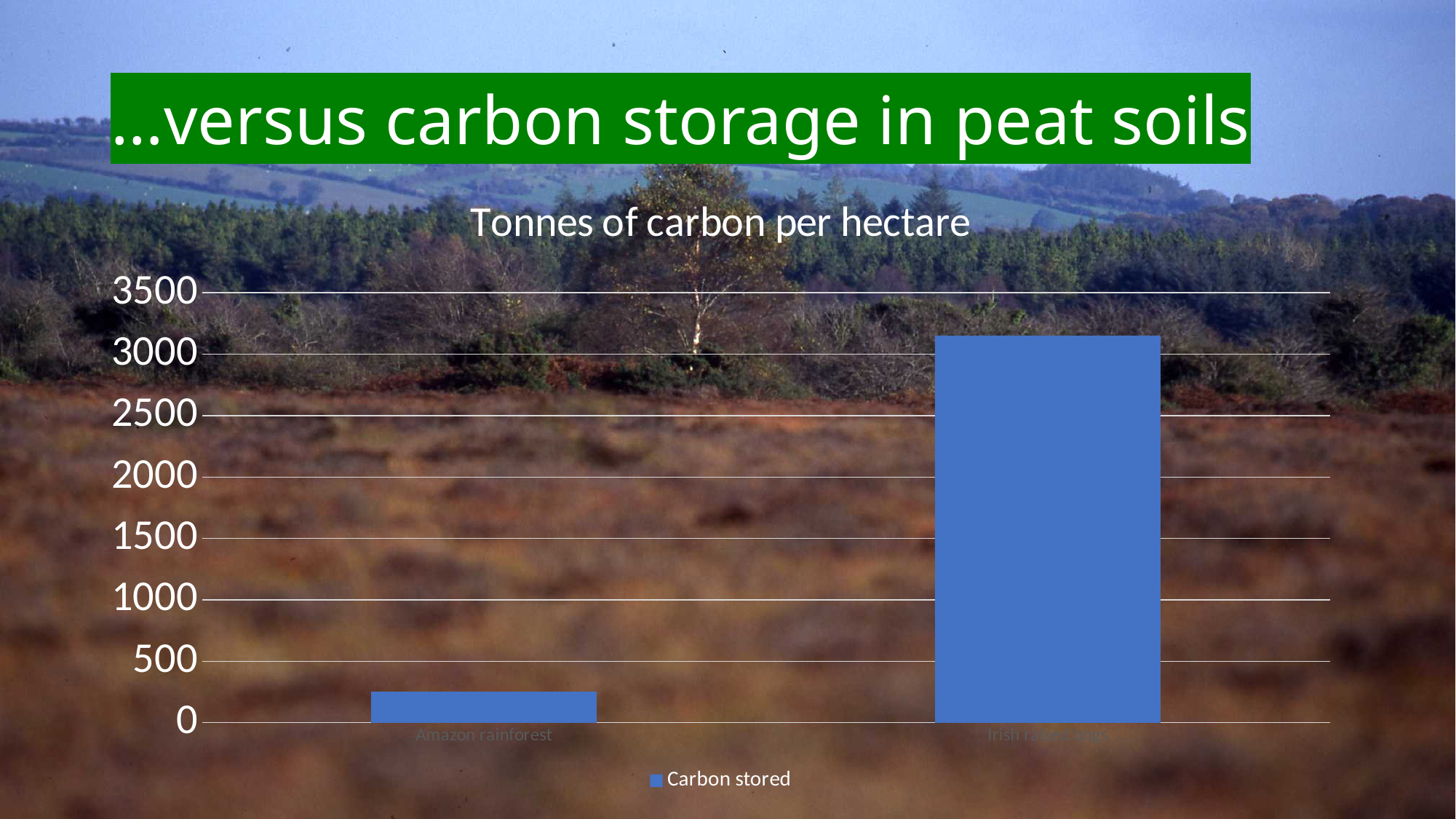
Which category has the highest value in the chart? Irish raised bogs Which is larger, the value for Amazon rainforest or the value for Irish raised bogs? Irish raised bogs Is the value for Irish raised bogs greater or less than 3000? greater Which category has the lowest value in the chart? Amazon rainforest Is the value for Amazon rainforest greater or less than 1000? less How many series does the chart legend list? 1 What is the title of the chart? Tonnes of carbon per hectare Is the value for Amazon rainforest greater or less than 500? less What is the name of the series shown in the legend? Carbon stored What kind of chart is shown on the slide? bar chart How many categories are plotted in the chart? 2